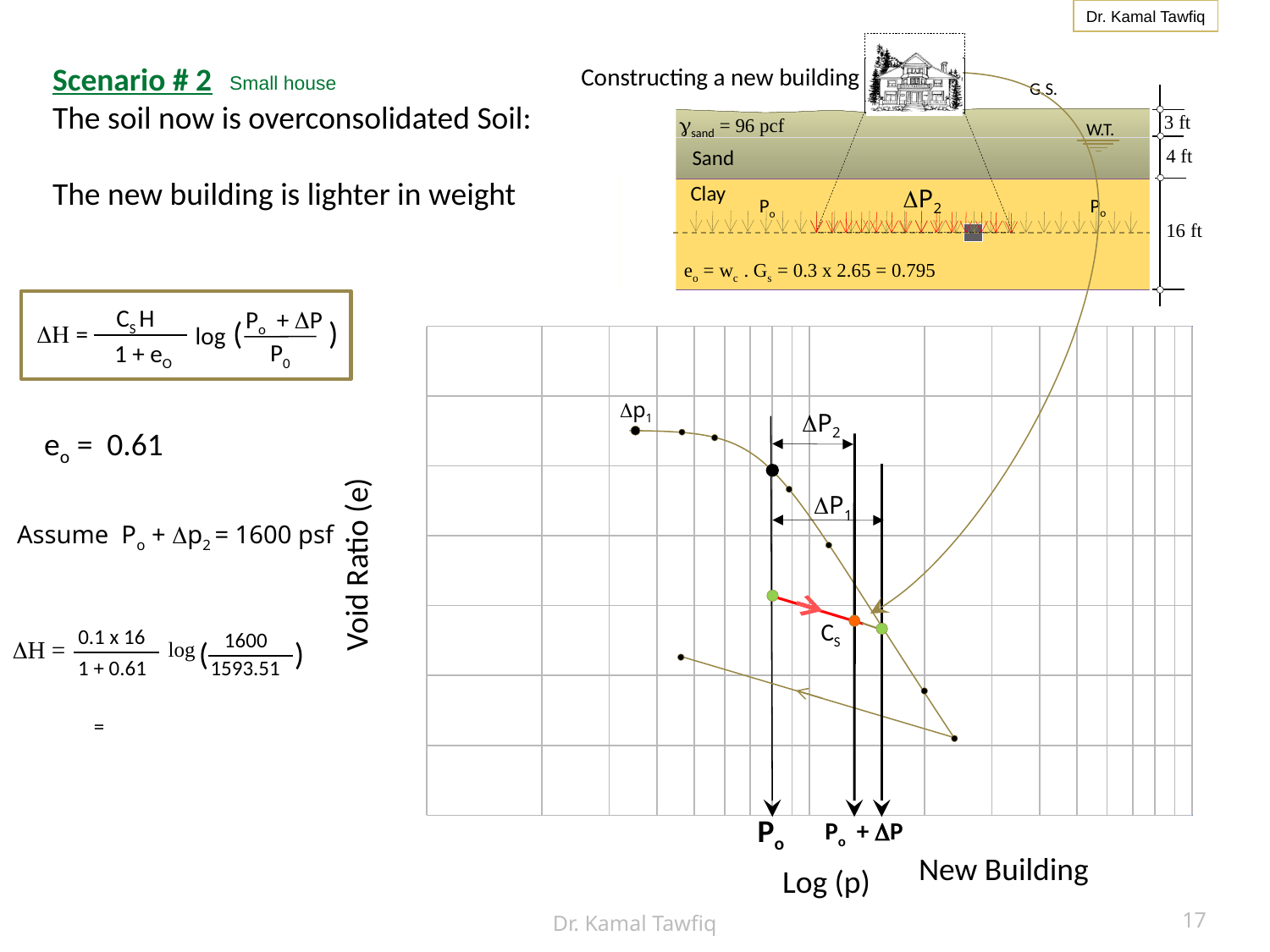
What is the label of the vertical axis of the chart? Void Ratio (e) On the chart, which horizontal span is longer, ΔP1 or ΔP2? ΔP1 As Log (p) increases along the x axis, does the void ratio on the curve rise or fall? fall What kind of chart is shown on the slide? line chart What is the label of the horizontal axis of the chart? Log (p) How many vertical arrowed lines are drawn down to the x axis of the chart? 3